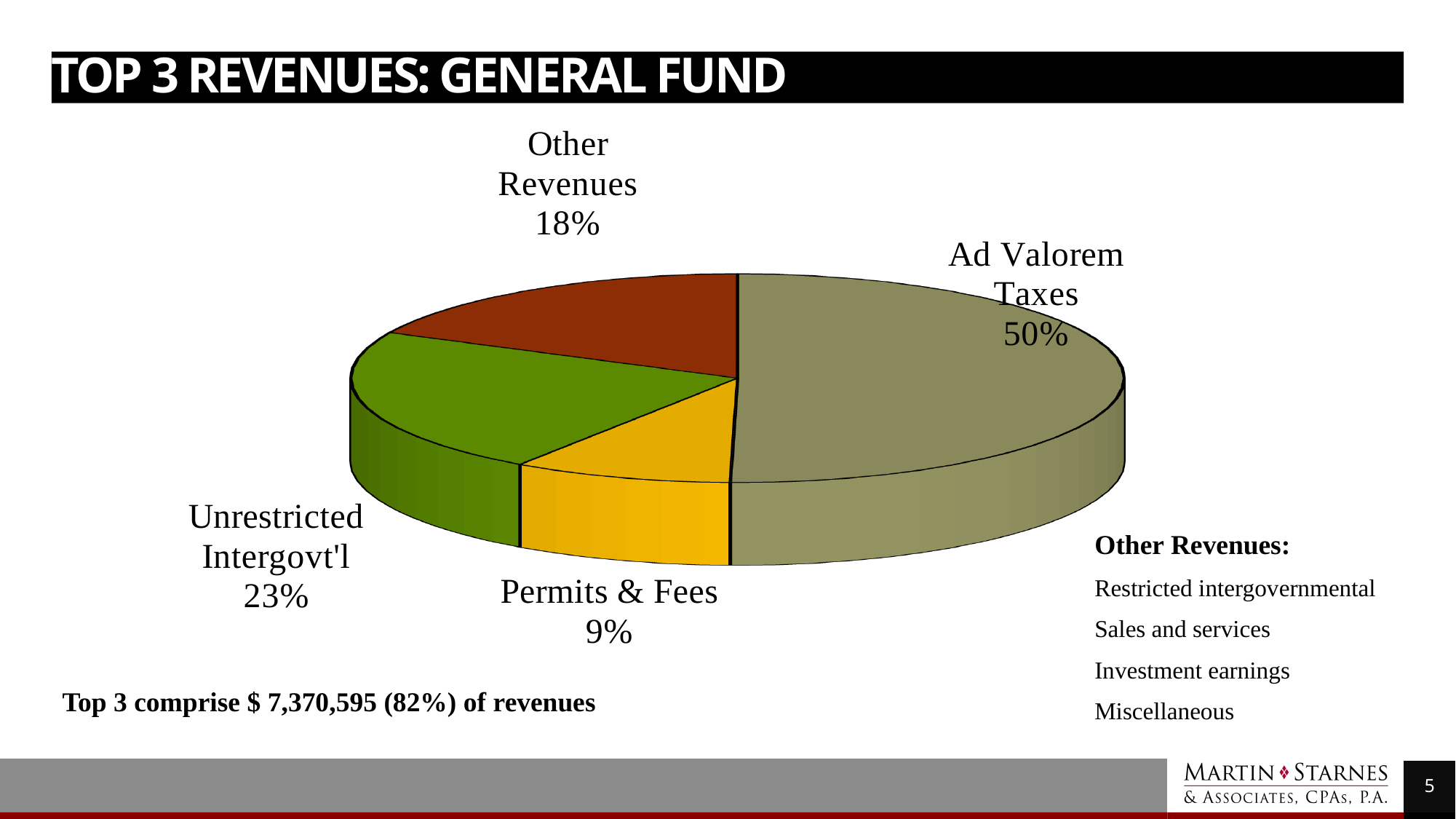
What colour is the Permits & Fees slice? Yellow What percentage is shown for Unrestricted Intergovt'l? 23% Which slice of the pie is the largest? Ad Valorem Taxes Which slice of the pie is the smallest? Permits & Fees How many slices does the pie chart have? 4 What percentage is shown for Permits & Fees? 9% What share of the pie does Ad Valorem Taxes represent? 50% What percentage is shown for Other Revenues? 18% What is the title of the slide containing the chart? TOP 3 REVENUES: GENERAL FUND Which is larger, Other Revenues or Unrestricted Intergovt'l? Unrestricted Intergovt'l What is the difference in percentage points between Ad Valorem Taxes and Unrestricted Intergovt'l? 27 What kind of chart is shown on the slide? Pie chart